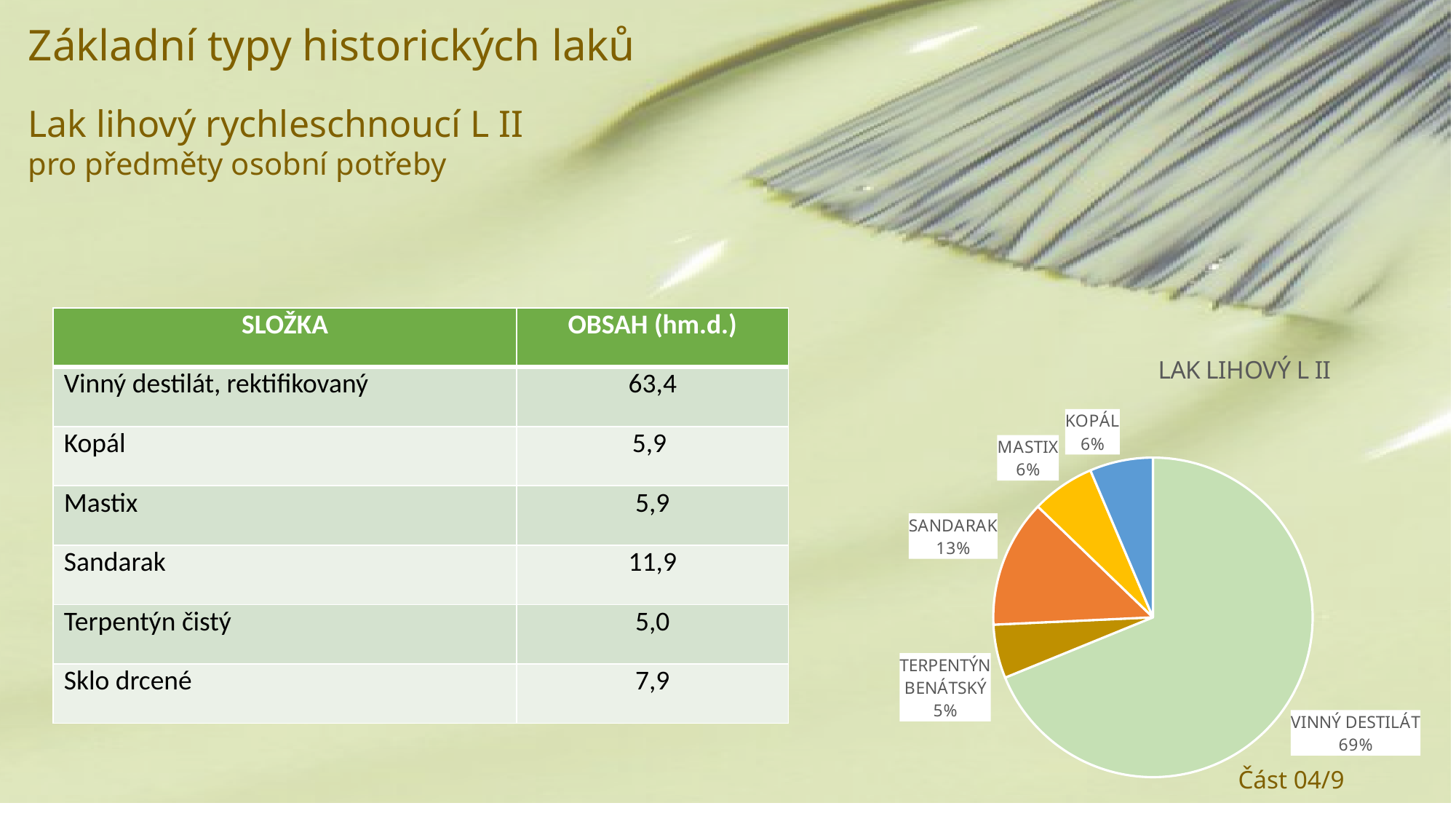
What share of the pie does MASTIX have? 6% What kind of chart is shown on the slide? pie chart What share of the pie does KOPÁL have? 6% What is the title of the pie chart? LAK LIHOVÝ L II What share of the pie does SANDARAK have? 13% How many slices does the pie chart have? 5 Which slice of the pie chart is the smallest? TERPENTÝN BENÁTSKÝ Which is larger in the pie chart, SANDARAK or KOPÁL? SANDARAK Which slice of the pie chart is the largest? VINNÝ DESTILÁT What is the difference in percentage points between the VINNÝ DESTILÁT slice and the SANDARAK slice? 56